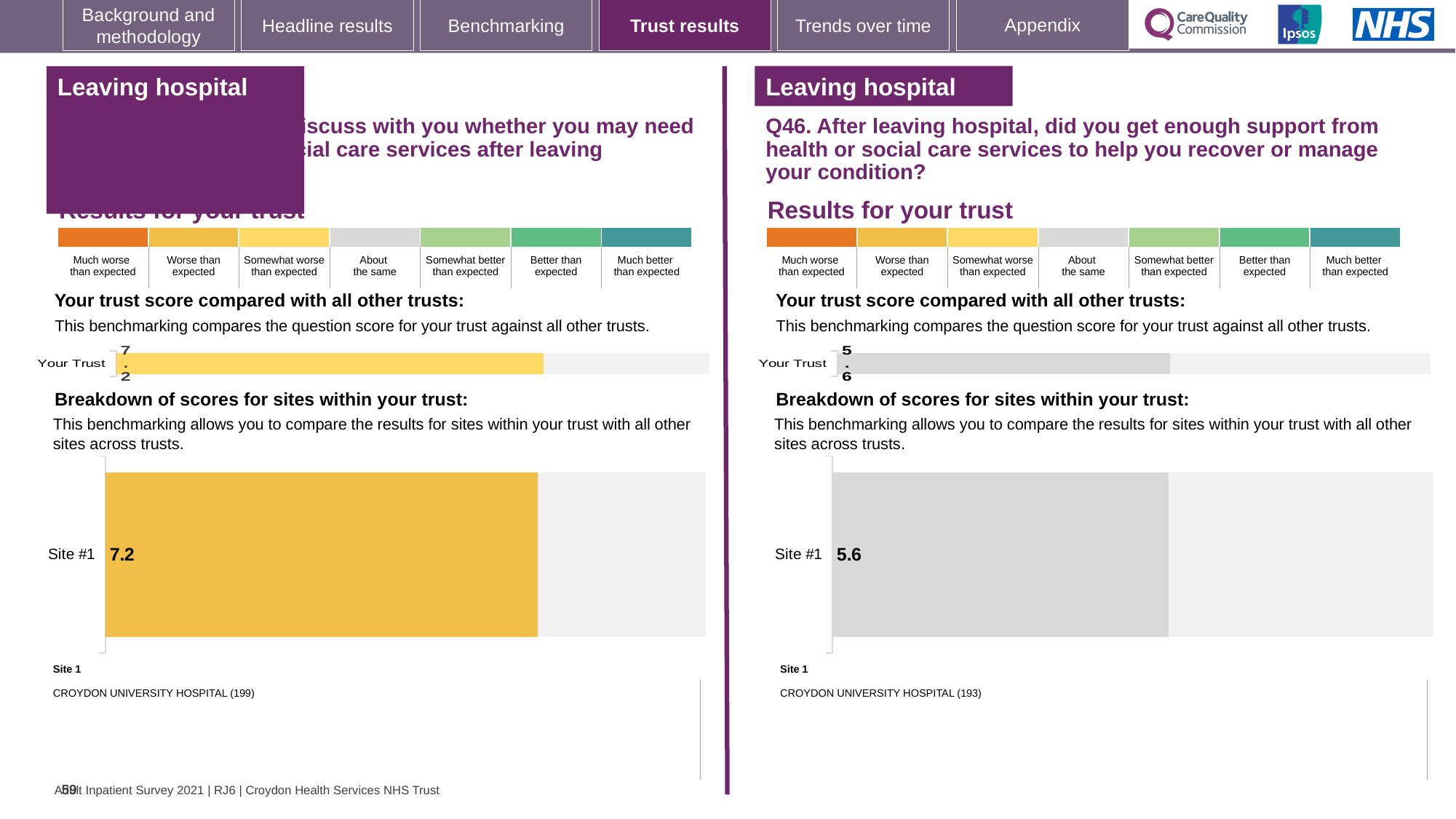
How many sites are shown in the Q46 right-hand 'Breakdown of scores for sites within your trust' chart? 1 Which Site #1 score is larger: the one on the left-hand breakdown chart or the one on the Q46 right-hand breakdown chart? The left-hand chart (7.2) What kind of chart is used to show the Site #1 score on the Q46 right-hand breakdown chart? Bar chart What is the difference between the Site #1 score on the left-hand breakdown chart and the Site #1 score on the Q46 right-hand breakdown chart? 1.6 How many rating categories are shown in the colour scale above the 'Your trust score' chart on the Q46 right-hand slide? 7 On the Q46 (right-hand) 'Breakdown of scores for sites within your trust' chart, what is the score for Site #1? 5.6 On the Q46 (right-hand) 'Your trust score compared with all other trusts' chart, what is the score shown for Your Trust? 5.6 On the left-hand slide's 'Your trust score compared with all other trusts' chart, what is the score shown for Your Trust? 7.2 On the left-hand slide, which rating category does the yellow colour of the Your Trust bar correspond to in the colour scale? Somewhat worse than expected On the Q46 right-hand slide, which rating category does the grey colour of the Your Trust bar correspond to in the colour scale? About the same Is the Your Trust score on the Q46 right-hand chart greater or less than the Your Trust score on the left-hand chart? less On the left-hand slide's 'Breakdown of scores for sites within your trust' chart, what is the score for Site #1? 7.2